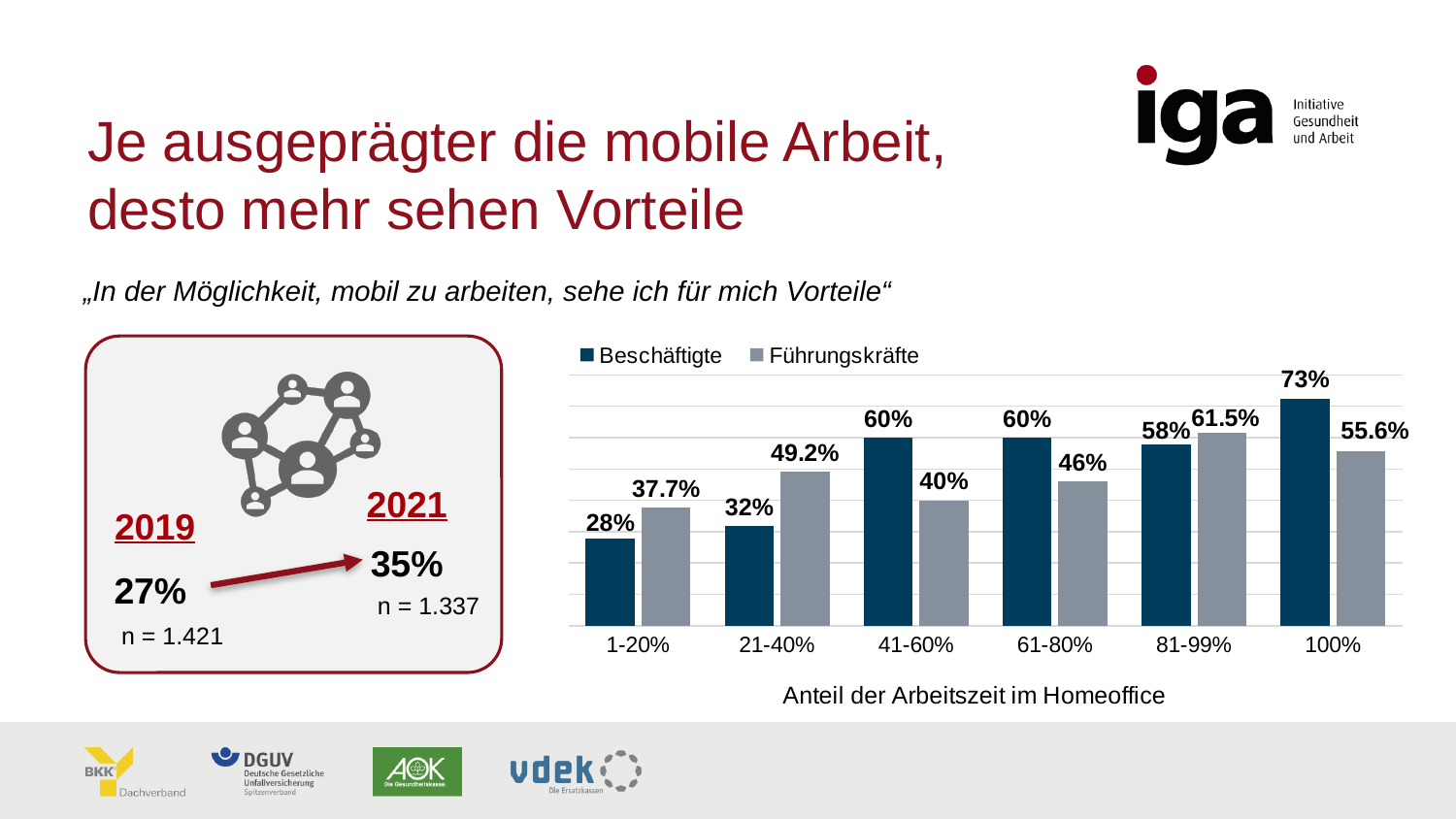
In the 81-99% category, which series has the larger value, Beschäftigte or Führungskräfte? Führungskräfte What is the value for Führungskräfte in the 21-40% category? 49.2% What is the difference between the Beschäftigte values for the 100% and 1-20% categories? 45% Which category has the lowest value for Führungskräfte? 1-20% What is the x-axis title of the chart? Anteil der Arbeitszeit im Homeoffice What is the value for Führungskräfte in the 100% category? 55.6% How many categories are shown on the x axis of the chart? 6 What is the value for Beschäftigte in the 1-20% category? 28% How many series does the chart legend list? 2 Which category has the highest value for Beschäftigte? 100% What kind of chart is shown on the slide? bar chart What is the difference between Beschäftigte and Führungskräfte in the 41-60% category? 20%